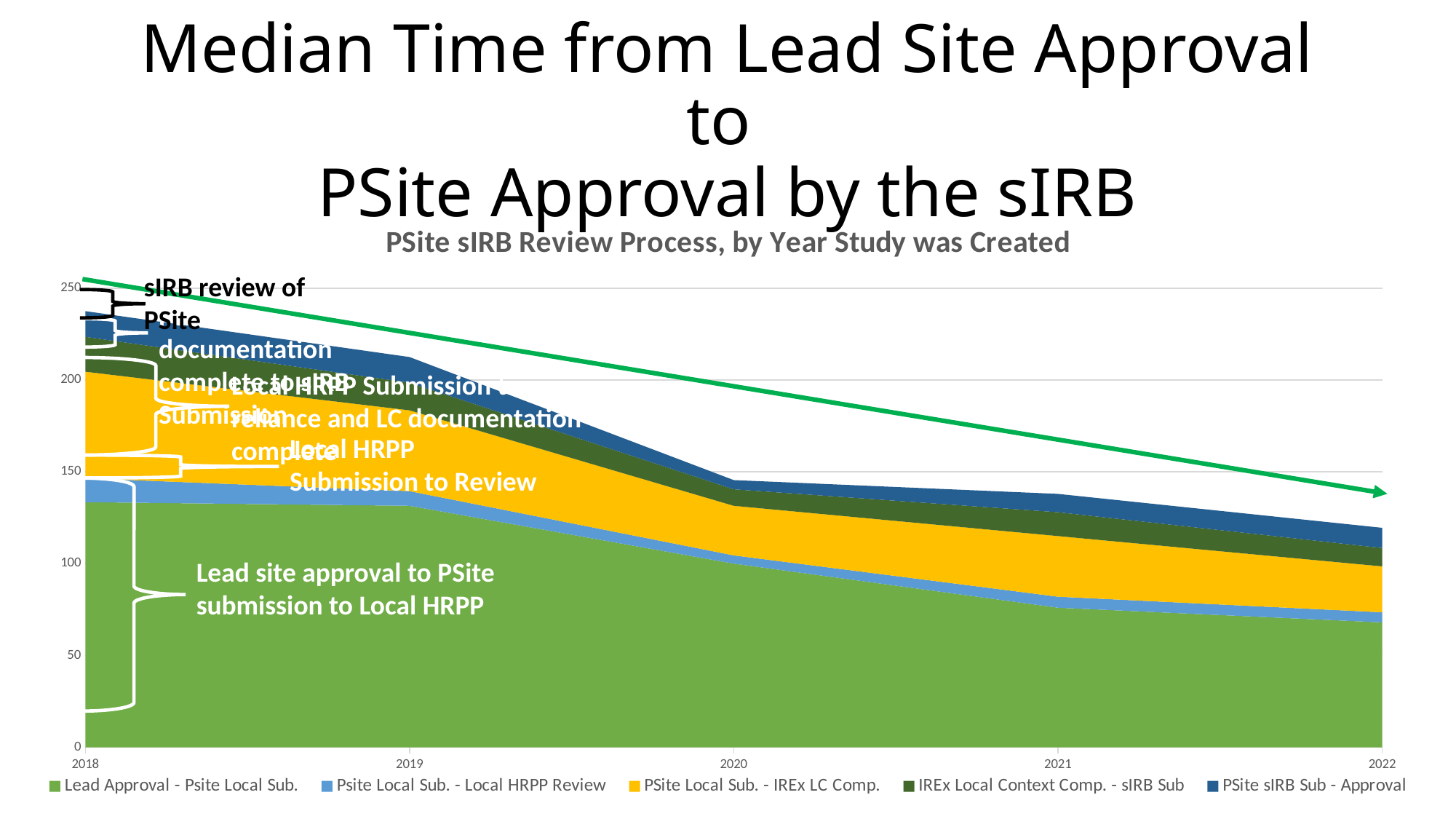
Which year has the highest total median time? 2018 What is the title of the chart? PSite sIRB Review Process, by Year Study was Created Is the value of the Lead Approval - Psite Local Sub. series in 2022 greater or less than 100? less Is the total median time for 2022 greater or less than 150? less Does the total median time rise or fall from 2018 to 2022? Fall How many series does the chart legend list? 5 Is the total median time for 2018 greater or less than 200? greater What kind of chart is shown on the slide? Stacked area chart Which year has the larger total median time, 2018 or 2022? 2018 Which year has the lowest total median time? 2022 How many years are shown along the x axis of the chart? 5